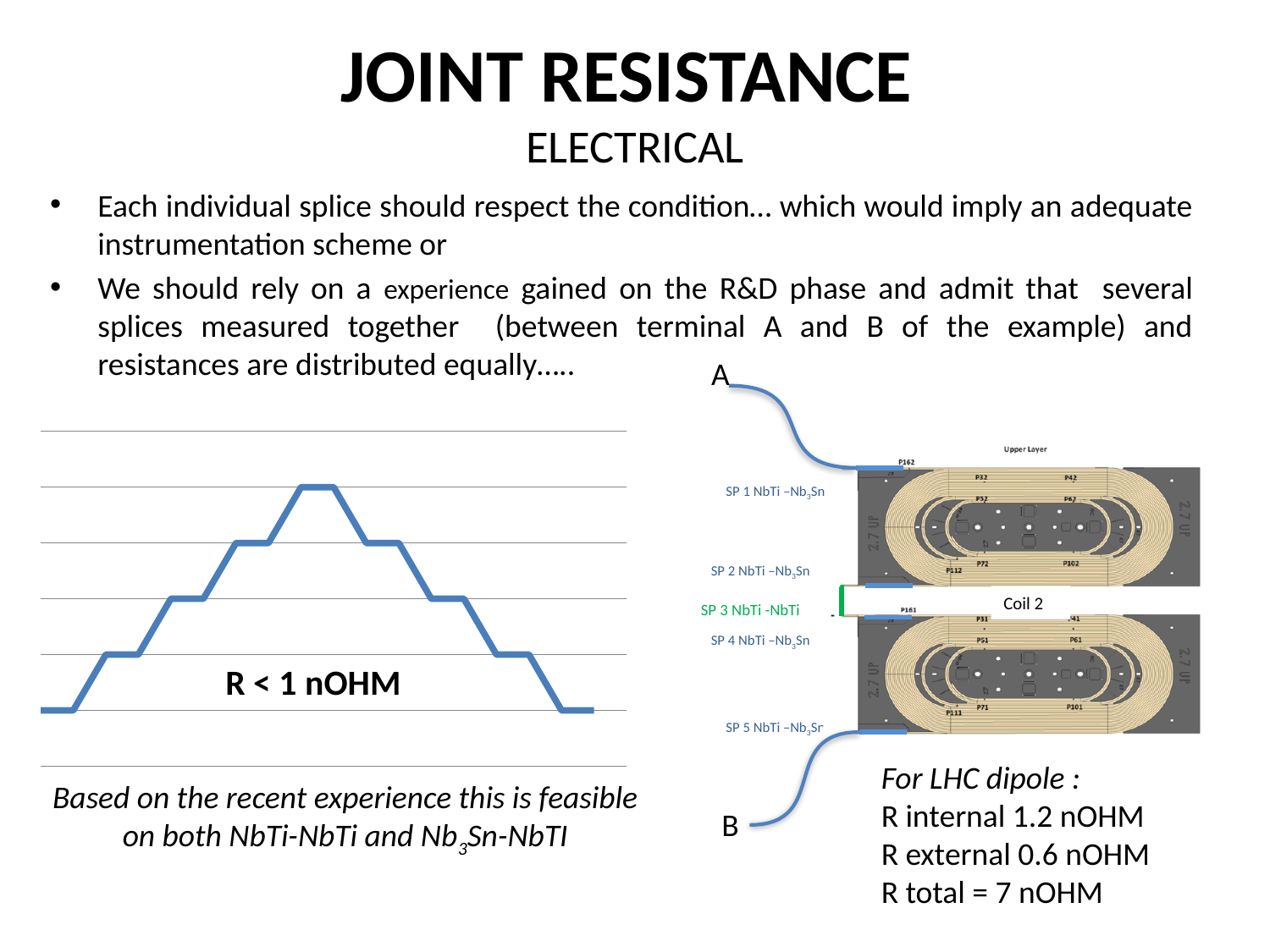
How many lines (series) are plotted in the chart on the left? 1 In the chart on the left, where along the x axis does the line reach its highest level: at the left end, in the middle, or at the right end? in the middle In the chart on the left, does the line rise or fall over the second half of the x axis? fall Does the chart on the left have a legend? No What kind of chart is shown on the left side of the slide? line chart In the chart on the left, does the line rise or fall over the first half of the x axis? rise What text annotation is printed inside the chart on the left? R < 1 nOHM